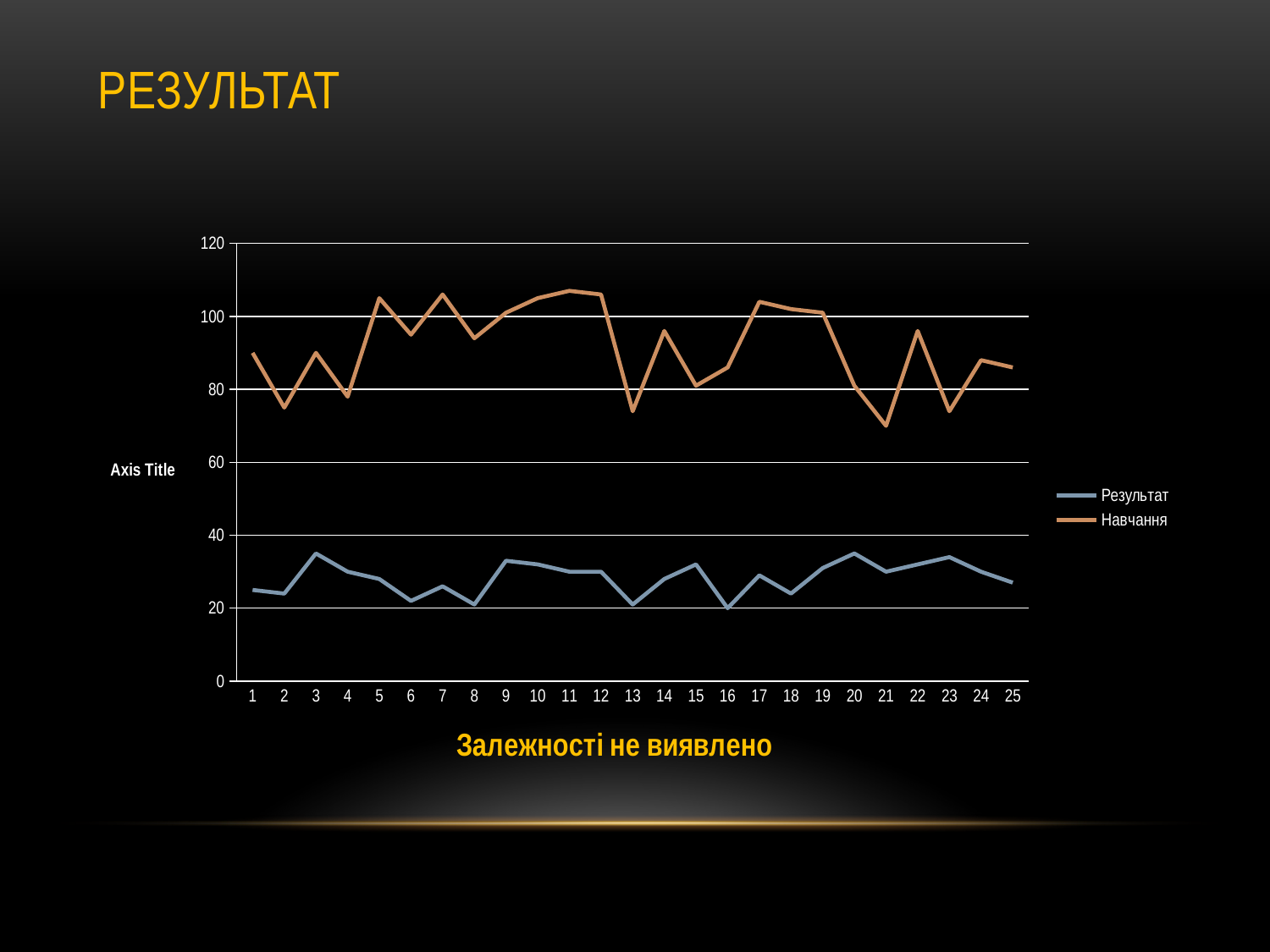
What caption is written in yellow below the chart? Залежності не виявлено Is the value of Результат at point 9 greater or less than 20? greater Which series has the larger value at point 5, Результат or Навчання? Навчання How many series does the legend list? 2 What kind of chart is shown on the slide? line chart Is the value of Результат at point 3 greater or less than 40? less How many points are plotted along the x axis for each series? 25 Is the value of Навчання at point 13 greater or less than 80? less Which series lies higher on the chart across all points? Навчання What are the two legend entries of the chart? Результат, Навчання